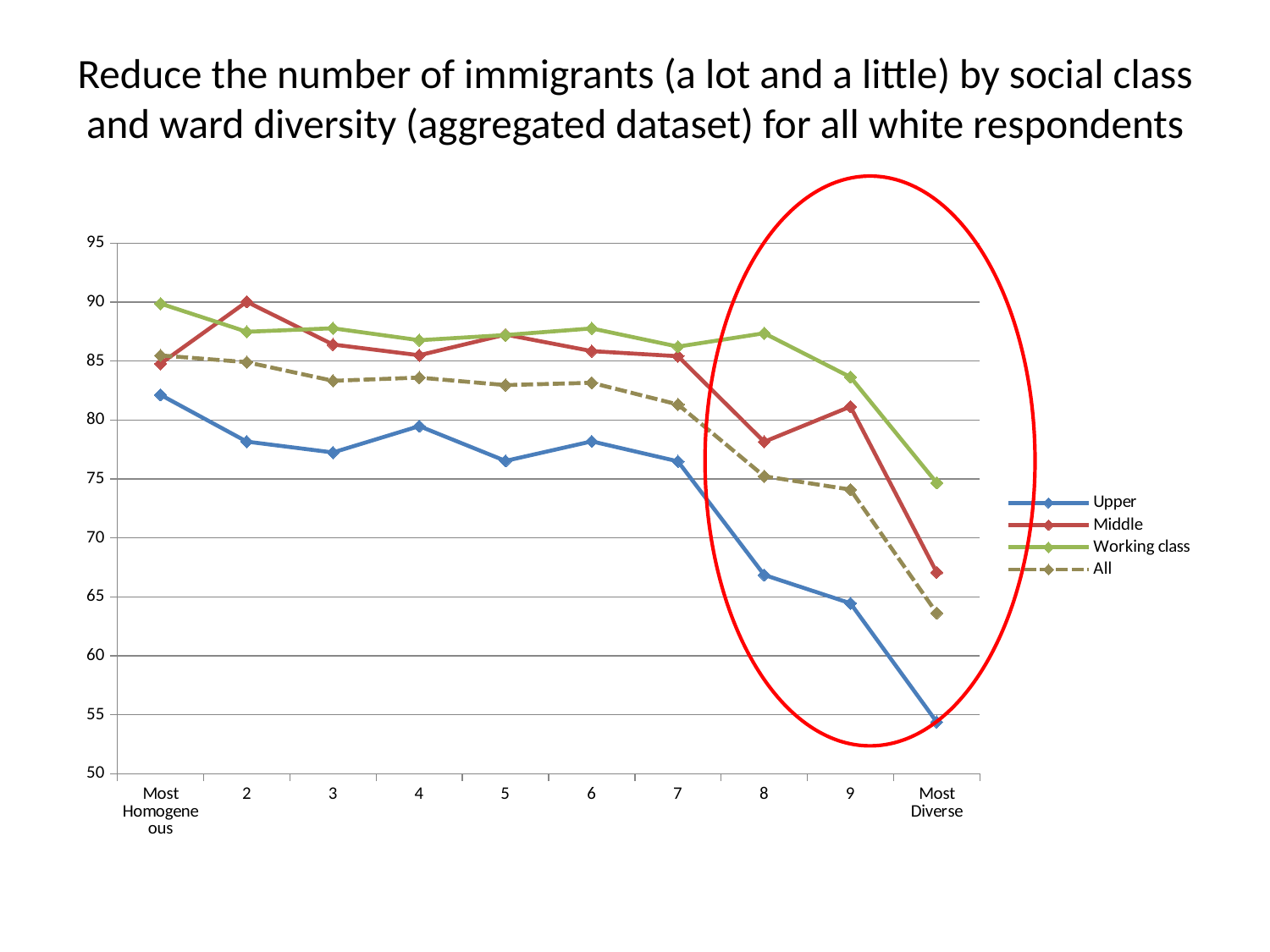
How many series does the legend list? 4 How many categories are shown along the x axis? 10 What kind of chart is shown on the slide? line chart Is the value for All at Most Diverse greater or less than 65? less Is the value for Working class at category 8 greater or less than 85? greater At category 5, which is larger: the Working class value or the Upper value? Working class Is the value for Upper at Most Diverse greater or less than 60? less For the Upper series, which category has the lowest value? Most Diverse Which series has the lowest value at the Most Diverse category? Upper Which series has the highest value at the Most Diverse category? Working class Does the Upper series generally rise or fall from Most Homogeneous to Most Diverse? fall